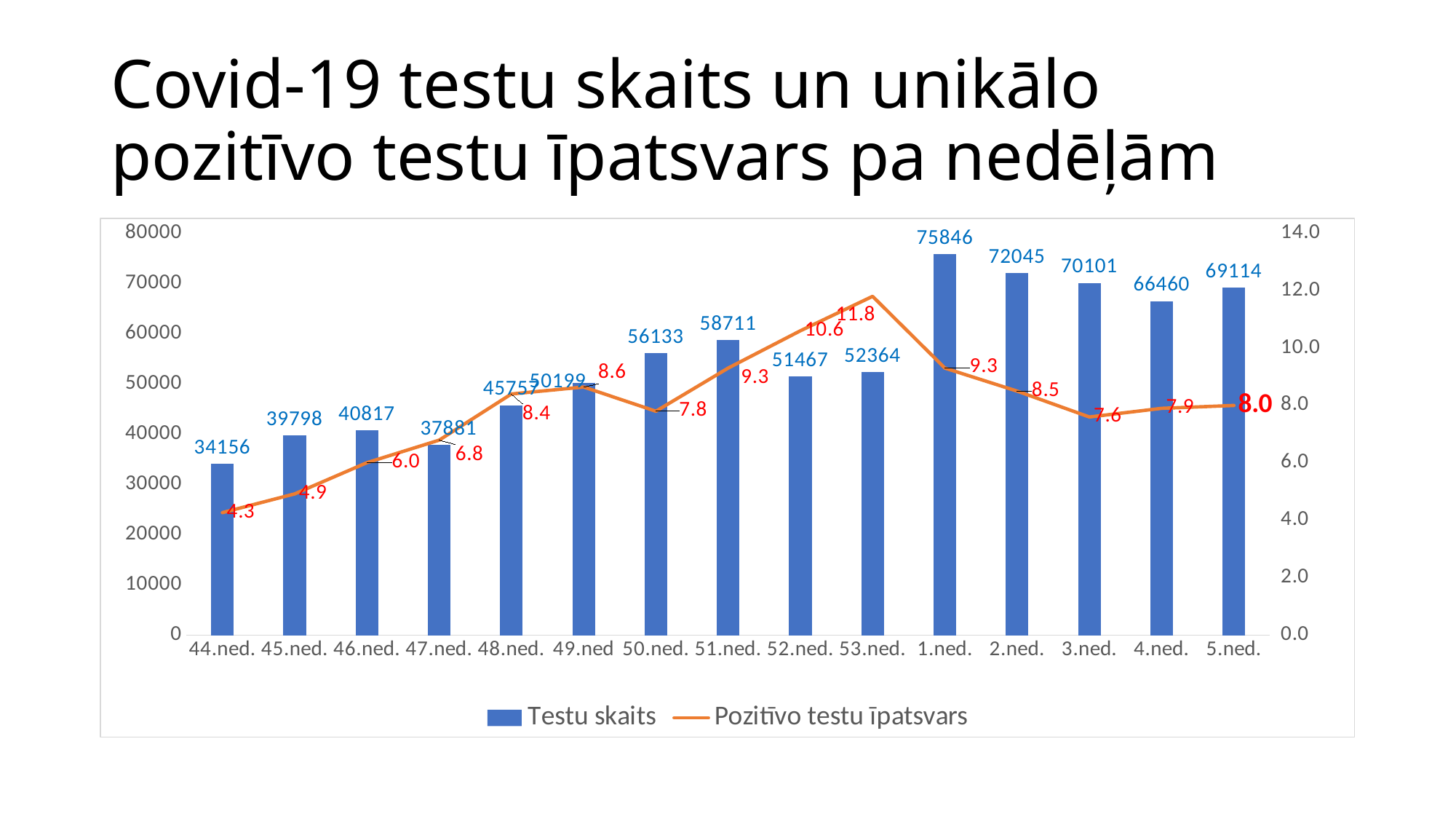
Which is larger, the Testu skaits for 51.ned. or for 52.ned.? 51.ned. Which week has the lowest Pozitīvo testu īpatsvars? 44.ned. What is the value of Testu skaits for 1.ned.? 75846 What is the Pozitīvo testu īpatsvars value for 53.ned.? 11.8 What is the Pozitīvo testu īpatsvars value for 5.ned.? 8.0 What kind of chart is shown on the slide? Combined bar and line chart Which week has the highest Testu skaits? 1.ned. Does the Pozitīvo testu īpatsvars rise or fall from 44.ned. to 53.ned.? Rise What is the difference in Testu skaits between 1.ned. and 2.ned.? 3801 What is the value of Testu skaits for 44.ned.? 34156 How many weeks are shown on the x axis? 15 How many series does the legend list? 2